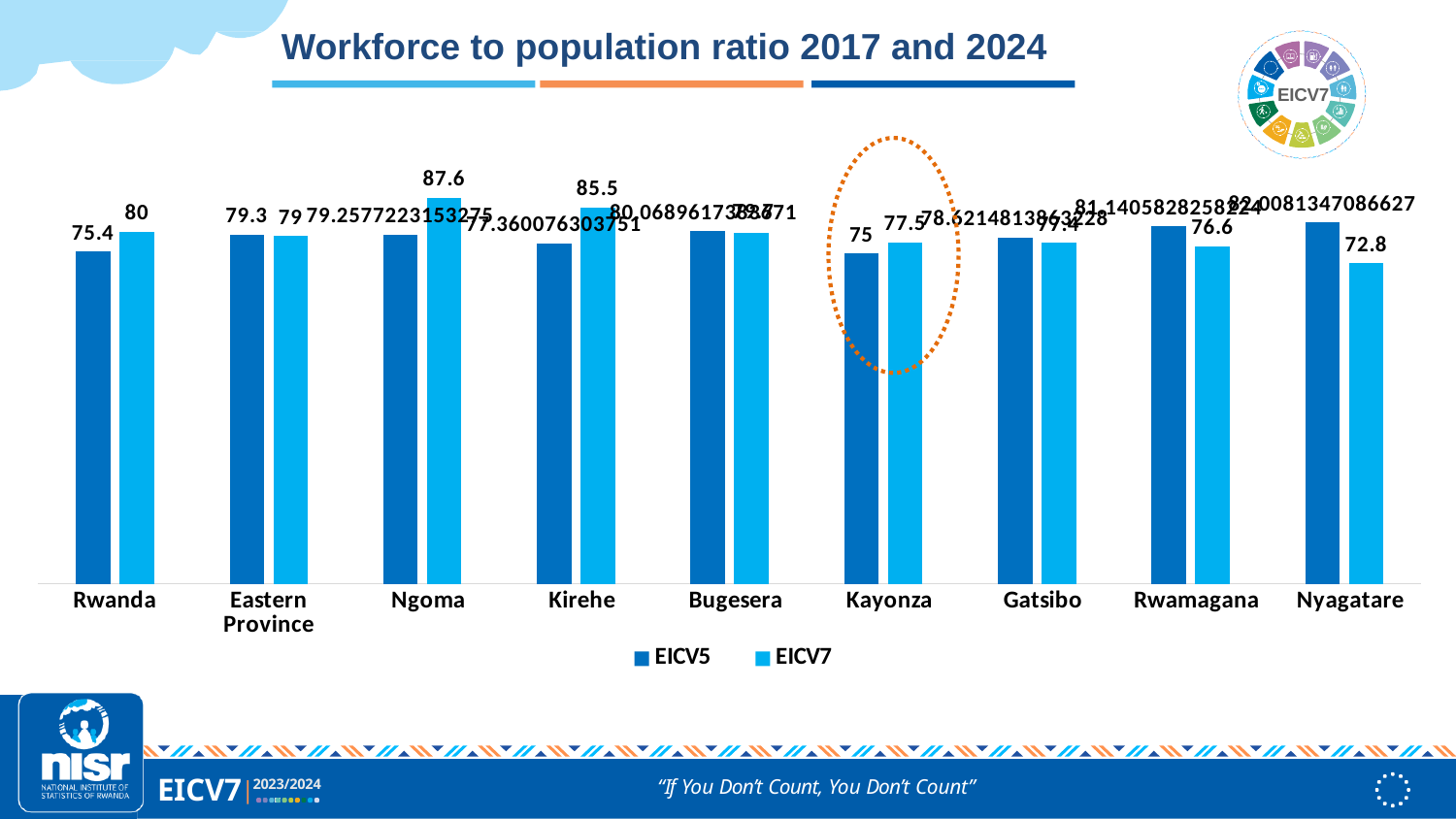
Which category has the highest EICV7 value? Ngoma What is the EICV7 value for Nyagatare? 72.8 Which is larger for Kayonza, the EICV5 value or the EICV7 value? EICV7 What is the difference between the EICV7 and EICV5 values for Rwanda? 4.6 How many series does the legend list? 2 What is the EICV7 value for Ngoma? 87.6 Which category has the lowest EICV7 value? Nyagatare What is the EICV7 value for Rwanda? 80 What kind of chart is shown on the slide? Bar chart How many categories are shown on the x axis? 9 What is the EICV5 value for Kayonza? 75 What is the EICV5 value for Rwanda? 75.4